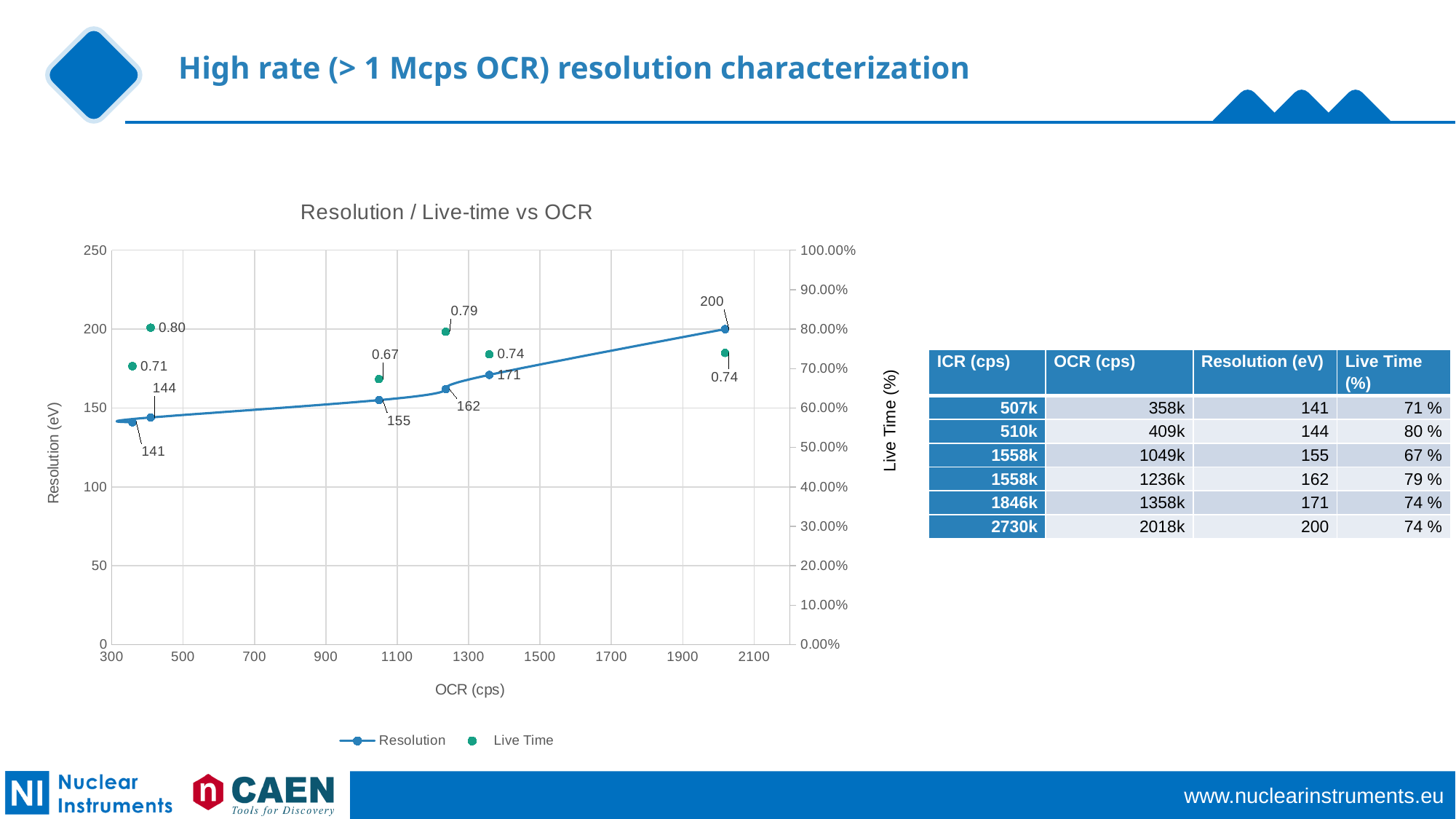
What is the Resolution data label for the rightmost point on the chart? 200 Is the Resolution value of the rightmost point greater or less than 150 on the left axis? greater What is the highest Resolution data label shown on the chart? 200 Does the Resolution series rise or fall as OCR increases along the x axis? rise What is the difference between the highest and lowest Resolution data labels on the chart? 59 What are the two series named in the chart legend? Resolution and Live Time What is the lowest Resolution data label shown on the chart? 141 How many data points are plotted for the Resolution series? 6 What is the highest Live Time data label shown on the chart? 0.80 What is the title of the chart? Resolution / Live-time vs OCR What is the lowest Live Time data label shown on the chart? 0.67 How many series does the chart legend list? 2